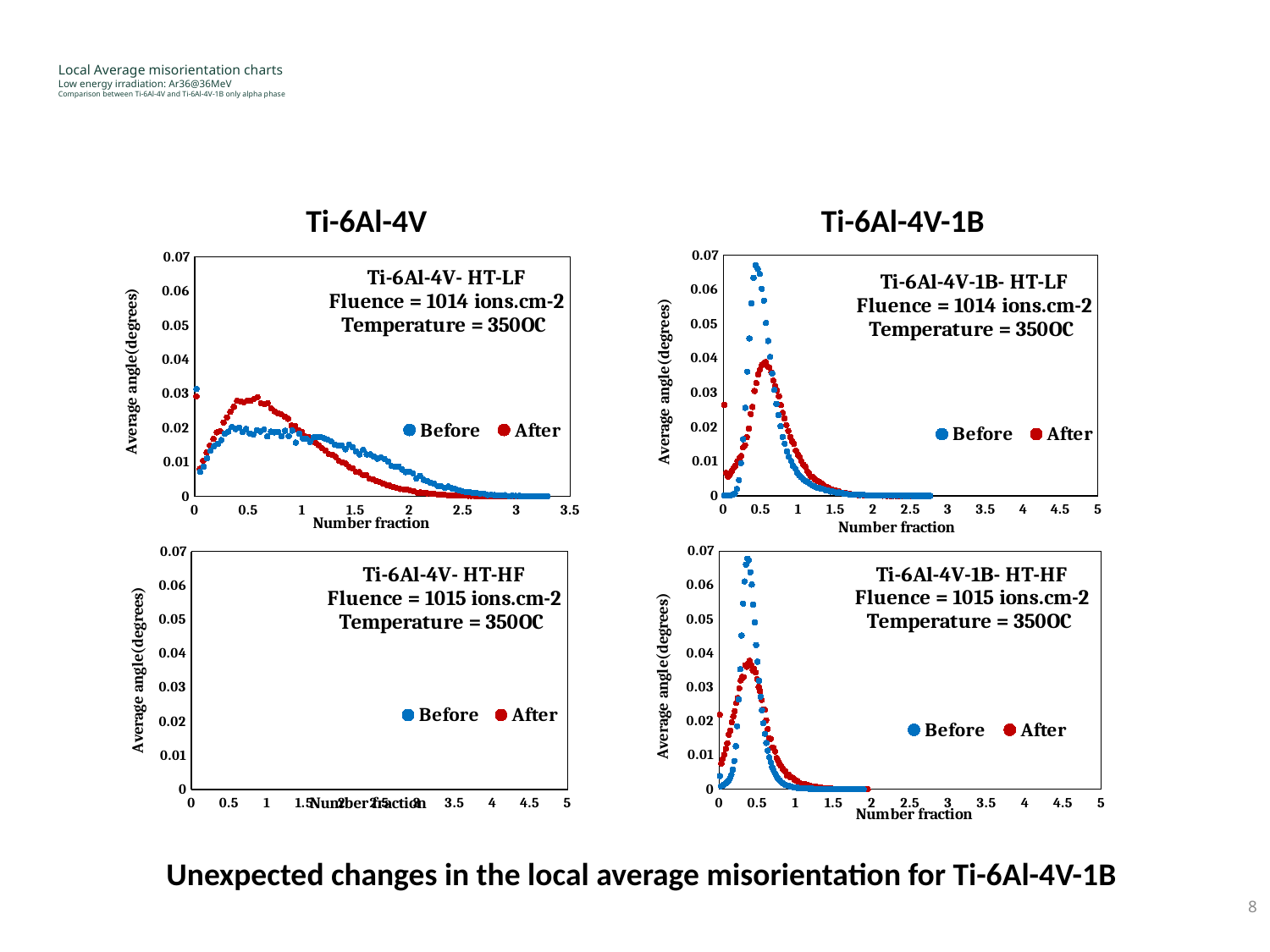
In the Ti-6Al-4V-1B- HT-LF chart (top right), is the peak value of the Before series greater or less than 0.06? greater What kind of chart is the Ti-6Al-4V- HT-LF chart (top left)? scatter chart In the Ti-6Al-4V- HT-LF chart (top left), is the peak value of the After series greater or less than 0.02? greater In the Ti-6Al-4V-1B- HT-HF chart (bottom right), which series reaches a higher peak, Before or After? Before How many series does the legend of the Ti-6Al-4V-1B- HT-LF chart (top right) list? 2 In the Ti-6Al-4V-1B- HT-LF chart (top right), is the peak value of the After series greater or less than 0.05? less What is the label of the y axis on the Ti-6Al-4V-1B- HT-HF chart (bottom right)? Average angle(degrees) What are the two legend entries on the Ti-6Al-4V- HT-HF chart (bottom left)? Before and After In the Ti-6Al-4V-1B- HT-LF chart (top right), which series reaches a higher peak, Before or After? Before